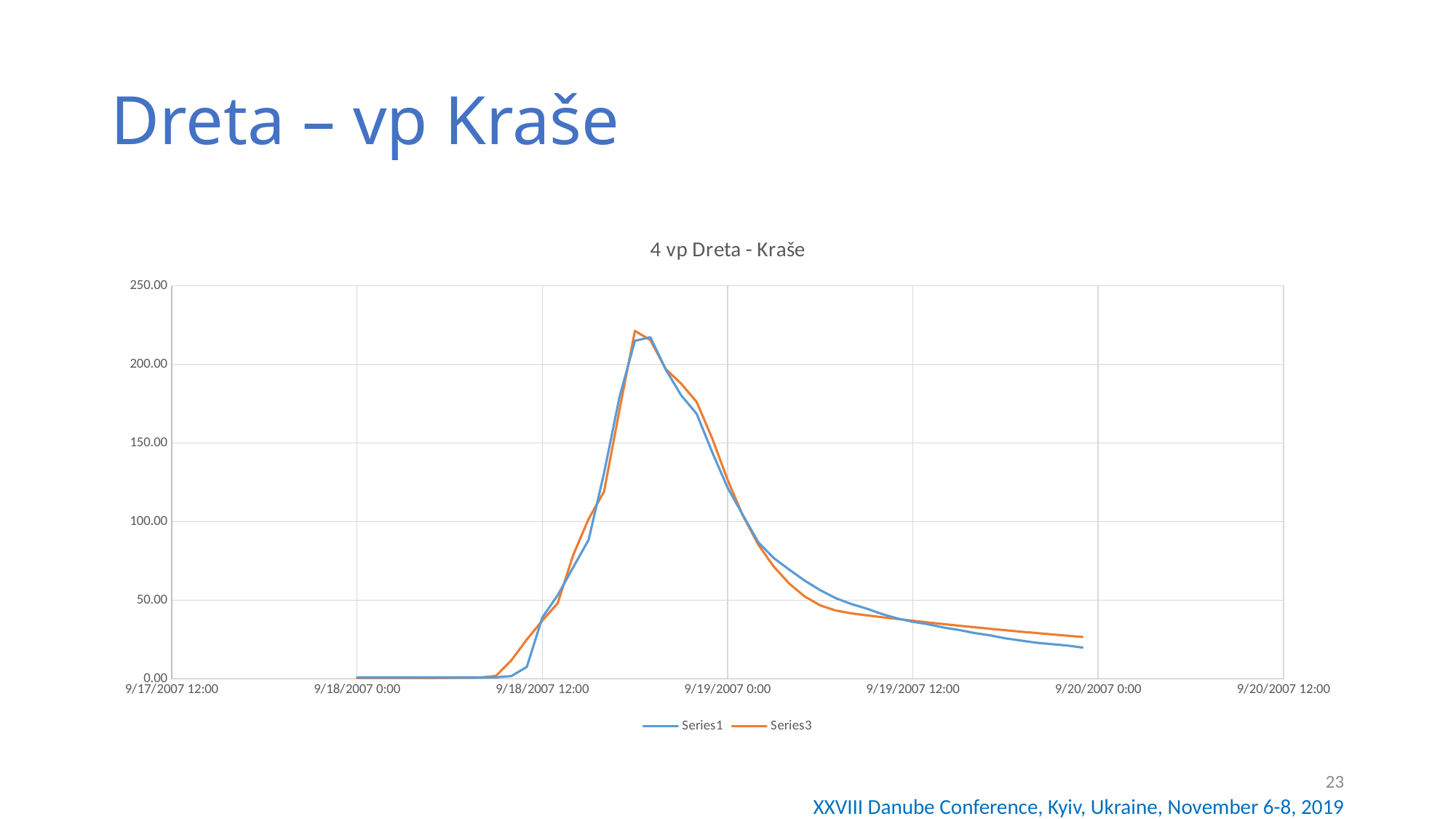
What is the title of the chart? 4 vp Dreta - Kraše What kind of chart is shown on the slide? line chart Is the peak value of Series3 greater or less than 250? less How many series does the legend list? 2 Do the values of Series1 rise or fall between 9/19/2007 0:00 and 9/20/2007 0:00? fall Is the peak value of Series1 greater or less than 200? greater Is the value of Series3 at 9/20/2007 0:00 greater or less than 50? less Which series is drawn in orange? Series3 At 9/20/2007 0:00, which series has the higher value, Series1 or Series3? Series3 Do the values of Series3 rise or fall between 9/18/2007 12:00 and the peak? rise